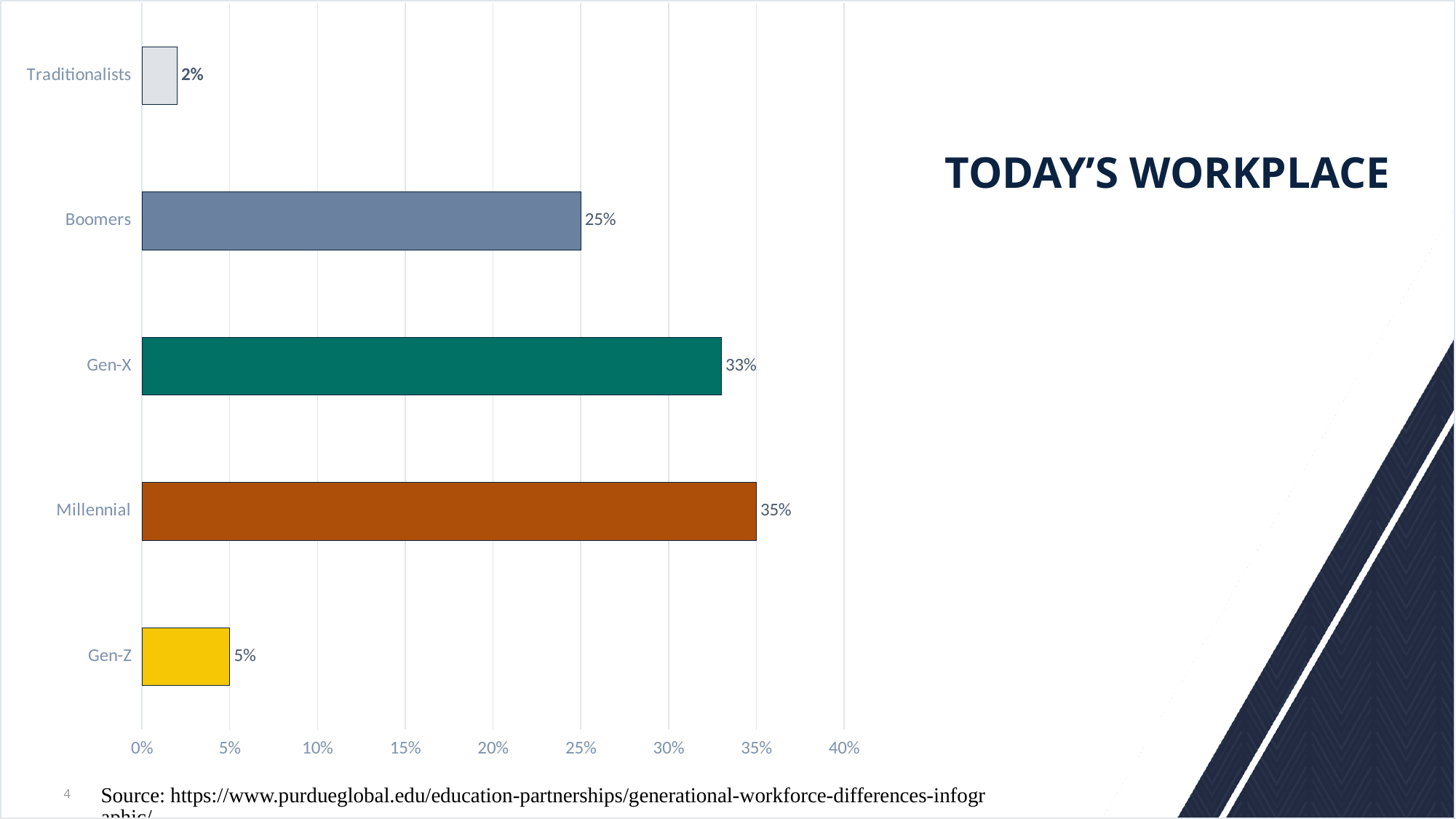
What kind of chart is shown on the slide? bar chart Which category has the highest value? Millennial Is the value for Gen-X greater or less than 30%? greater What is the difference between the values for Gen-X and Boomers? 8% What is the title shown on the slide next to the chart? TODAY'S WORKPLACE Which category has the lowest value? Traditionalists What is the value for Millennial? 35% What is the value for Boomers? 25% Which is larger, the value for Gen-Z or the value for Traditionalists? Gen-Z How many categories are shown in the chart? 5 What is the value for Traditionalists? 2% What is the value for Gen-Z? 5%